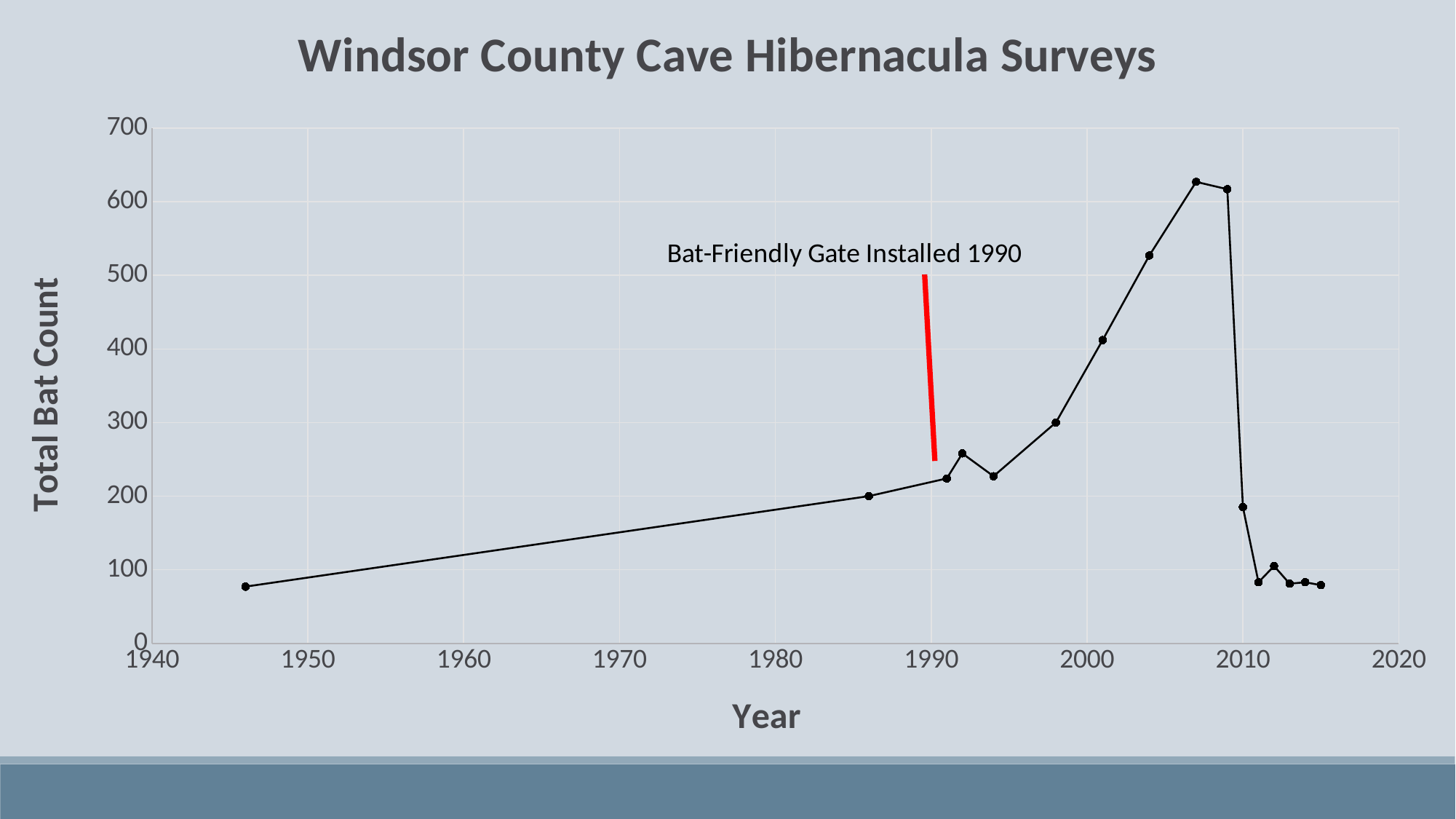
What does the annotation on the chart say? Bat-Friendly Gate Installed 1990 Does the total bat count rise or fall between 1990 and 2007? rise Is the highest point on the line greater or less than 600? greater Is the value for the point near 2004 greater or less than 500? greater Is the value for the point near 2010 greater or less than 200? less Which is larger, the value near 2007 or the value near 2010? the value near 2007 Does the total bat count rise or fall between 2009 and 2011? fall What kind of chart is shown on the slide? line chart What is the title of the chart? Windsor County Cave Hibernacula Surveys